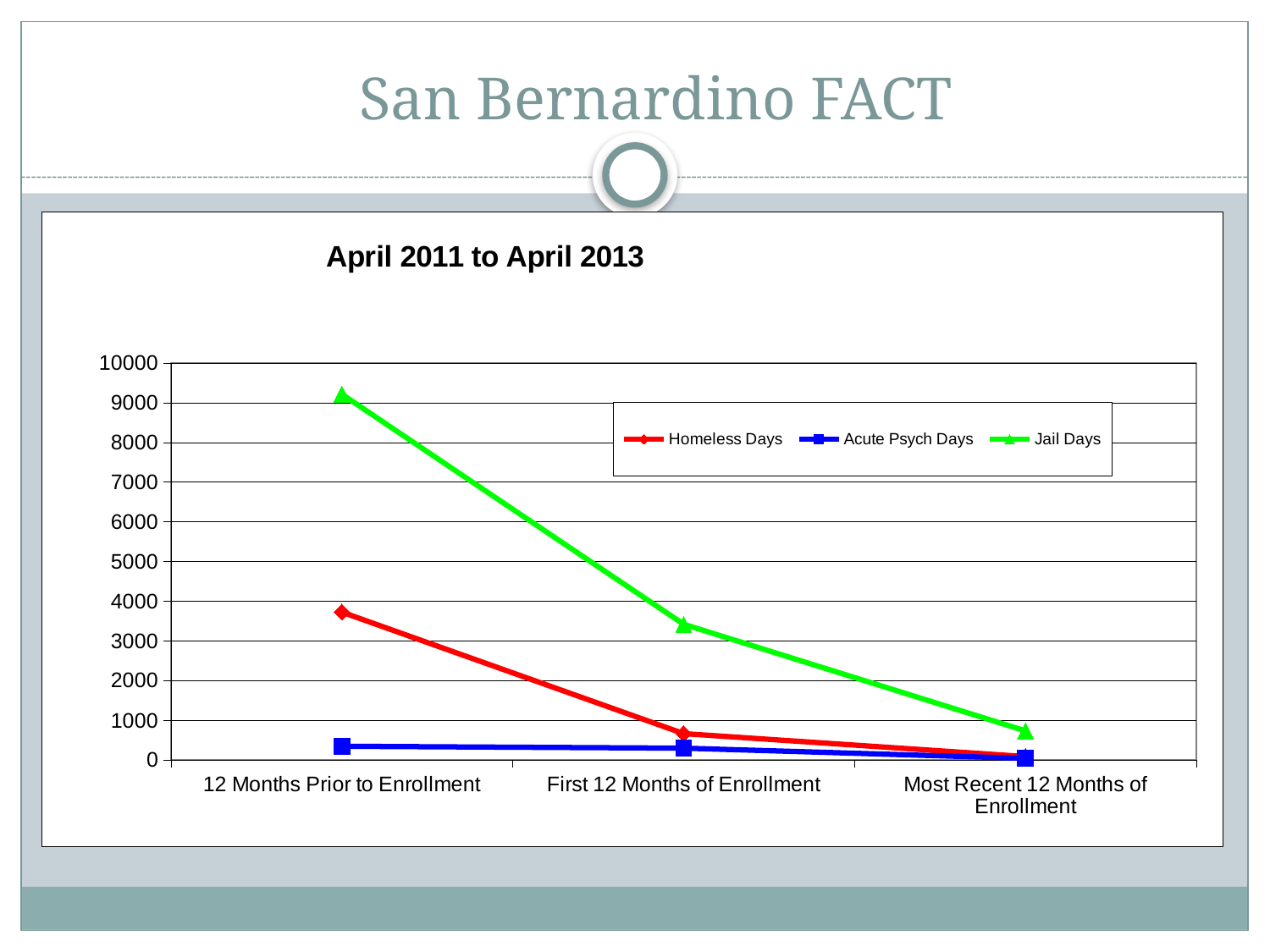
What is the title of the chart? April 2011 to April 2013 How many series does the legend list? 3 Which series has the highest value at 12 Months Prior to Enrollment? Jail Days Do the Jail Days values rise or fall from 12 Months Prior to Enrollment to Most Recent 12 Months of Enrollment? fall Is the Jail Days value at 12 Months Prior to Enrollment greater or less than 8000? greater Which series has the lowest value at 12 Months Prior to Enrollment? Acute Psych Days Which series is represented by the green line with triangle markers? Jail Days Do the Homeless Days values rise or fall across the three periods? fall At First 12 Months of Enrollment, which is larger: Jail Days or Homeless Days? Jail Days Is the Homeless Days value at First 12 Months of Enrollment greater or less than 1000? less How many categories are shown along the x axis? 3 What kind of chart is shown on the slide? line chart